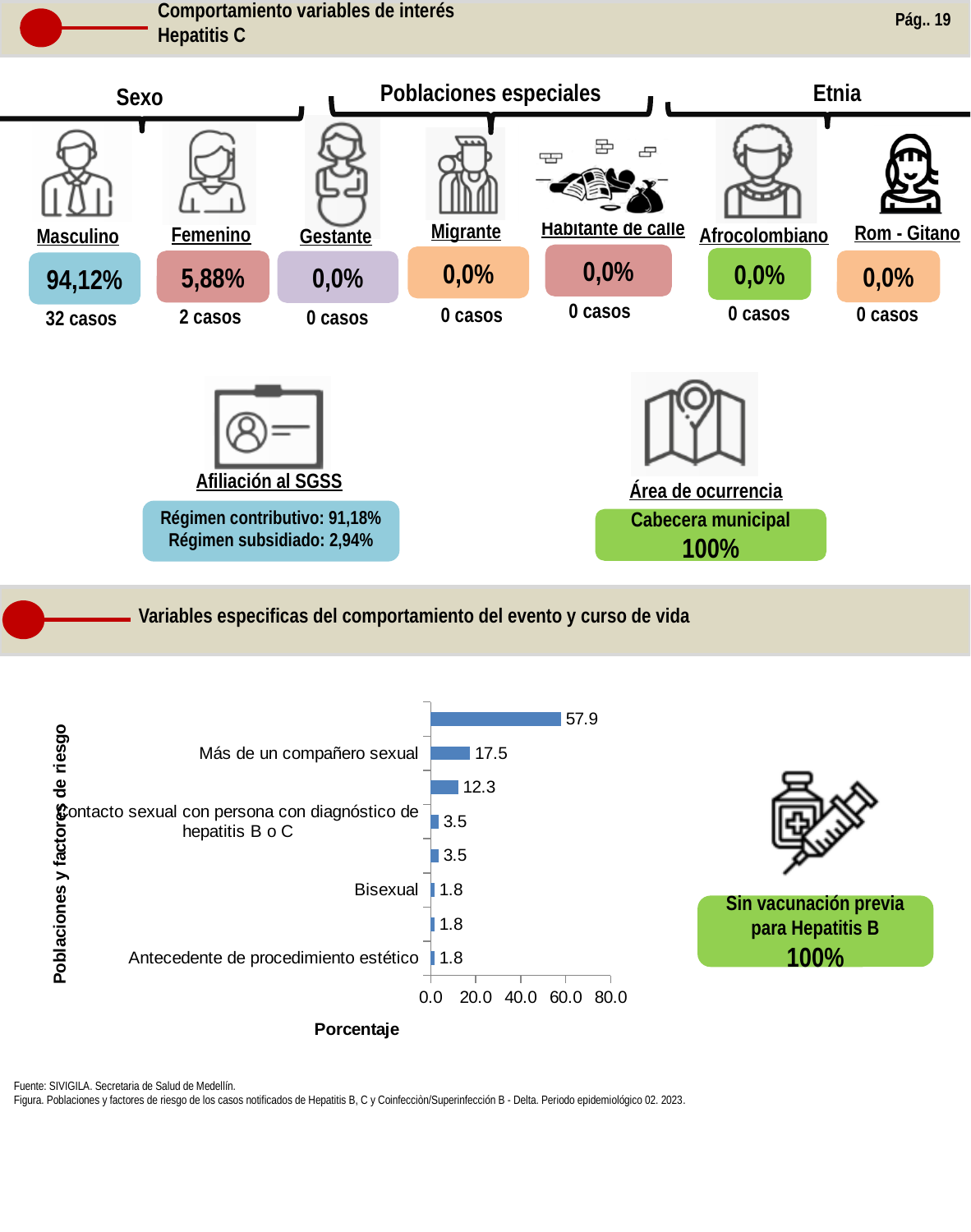
Which is larger: the value for "Más de un compañero sexual" or the value for "Contacto sexual con persona con diagnóstico de hepatitis B o C"? Más de un compañero sexual What kind of chart is shown on the slide? bar chart What is the value for "Contacto sexual con persona con diagnóstico de hepatitis B o C" in the bar chart? 3.5 What is the title of the vertical axis of the bar chart? Poblaciones y factores de riesgo What is the title of the horizontal axis of the bar chart? Porcentaje What is the highest value shown by any bar in the chart? 57.9 Is the value for "Más de un compañero sexual" greater or less than 20.0? less What is the difference between the values for "Más de un compañero sexual" and "Bisexual"? 15.7 What is the value for "Más de un compañero sexual" in the bar chart? 17.5 What is the value for "Antecedente de procedimiento estético" in the bar chart? 1.8 What is the value for "Bisexual" in the bar chart? 1.8 How many bars are plotted in the chart? 8